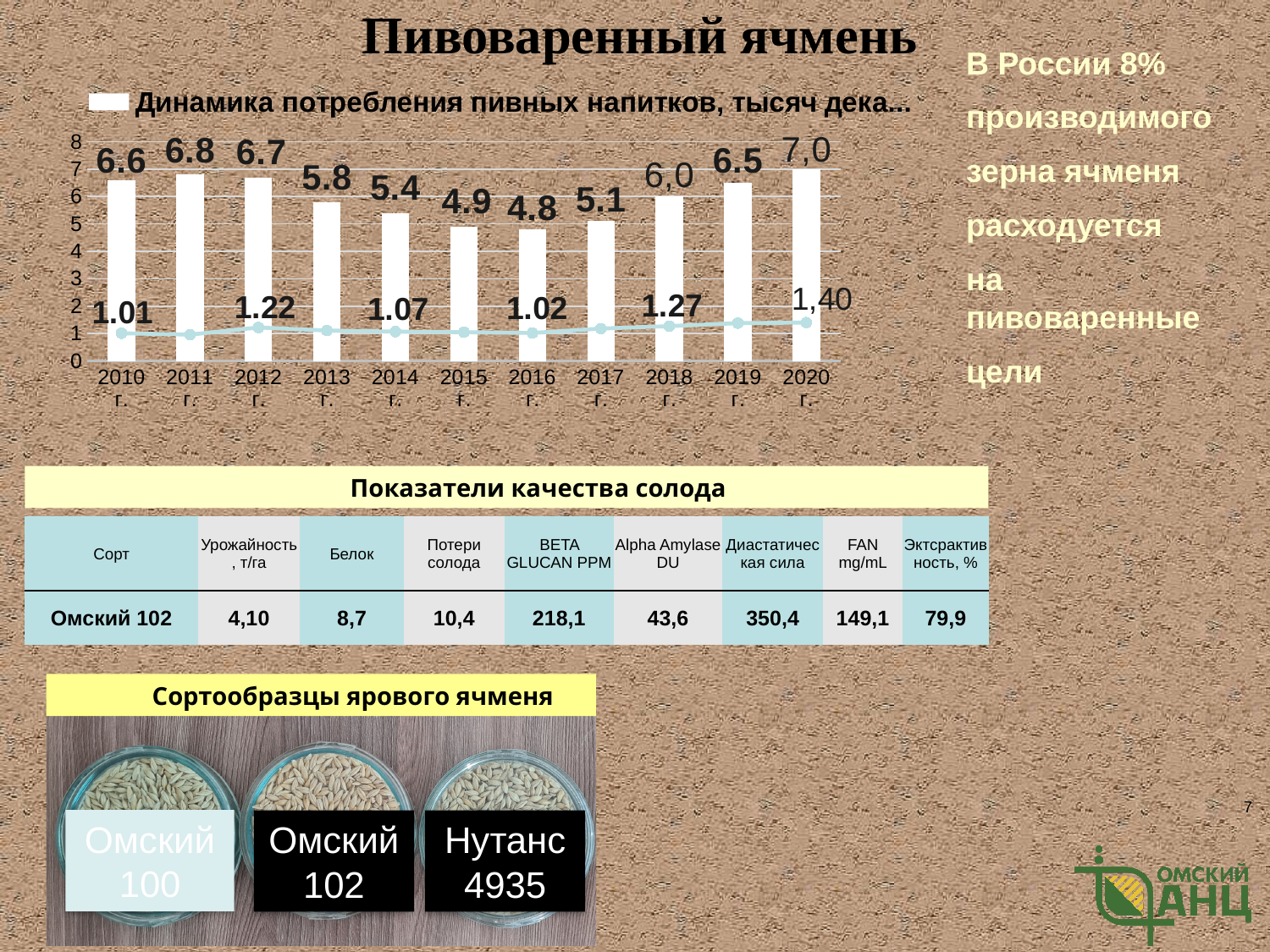
What is the value of the bar for 2020 г.? 7,0 What kind of chart is shown? bar chart with a line Is the line value for 2019 г. greater or less than 1? greater Which bar is taller, 2010 г. or 2019 г.? 2010 г. How many years are shown on the x axis? 11 What is the labelled value of the line series for 2018 г.? 1.27 Which year has the lowest bar? 2016 г. Do the bar values rise or fall from 2016 г. to 2020 г.? rise Which year has the highest bar? 2020 г. What is the difference between the bar values for 2011 г. and 2016 г.? 2.0 What is the labelled value of the line series for 2020 г.? 1,40 What is the value of the bar for 2013 г.? 5.8